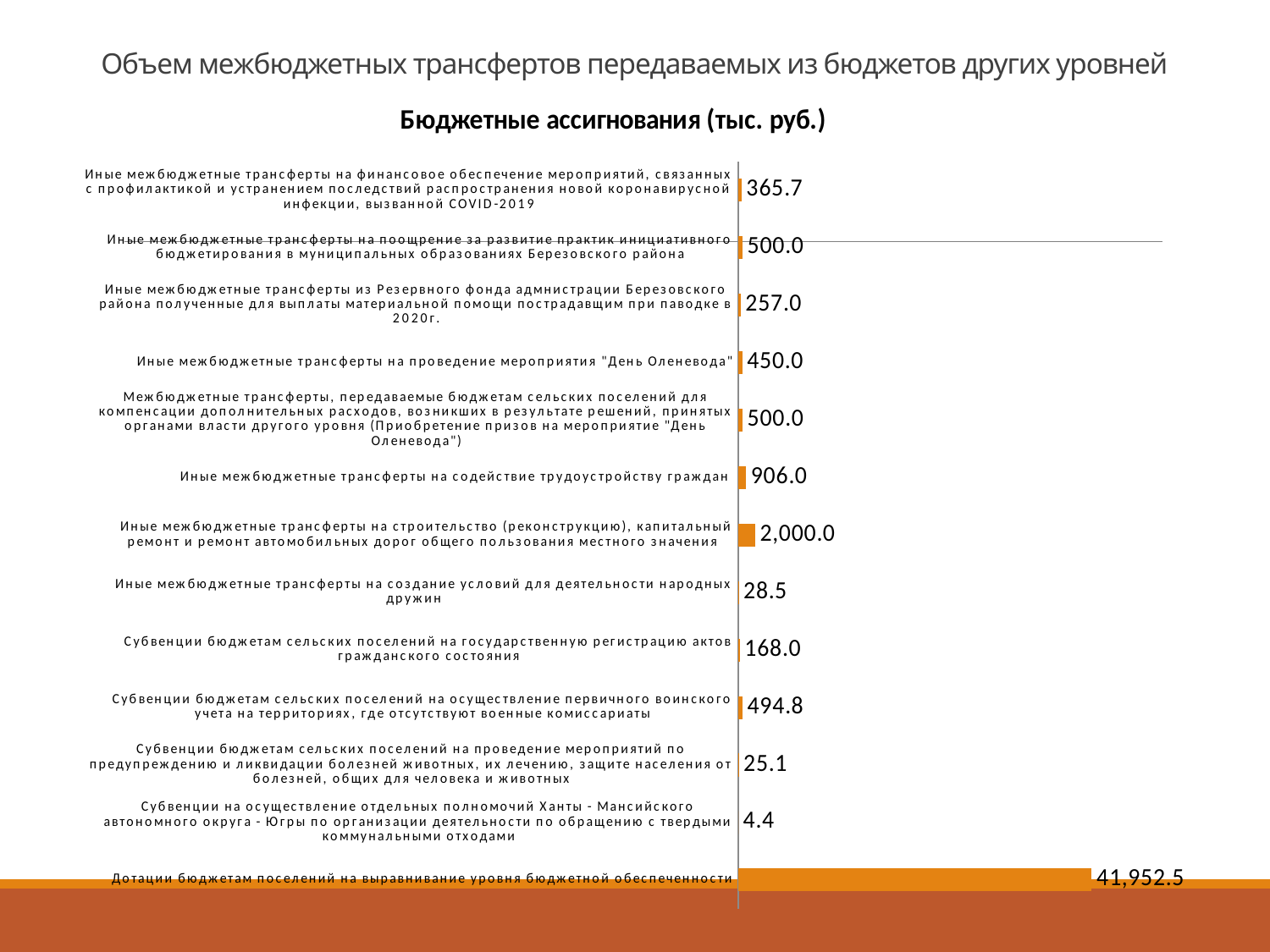
Which is larger: the value for "Субвенции бюджетам сельских поселений на осуществление первичного воинского учета" or the value for "Иные межбюджетные трансферты на проведение мероприятия "День Оленевода""? Субвенции бюджетам сельских поселений на осуществление первичного воинского учета (494.8) What is the value for "Иные межбюджетные трансферты на проведение мероприятия "День Оленевода""? 450.0 What is the difference between the value for transfers for road construction and repair (2,000.0) and the value for transfers for employment assistance (906.0)? 1,094.0 Which category has the highest value? Дотации бюджетам поселений на выравнивание уровня бюджетной обеспеченности What is the value for "Иные межбюджетные трансферты на содействие трудоустройству граждан"? 906.0 What type of chart is shown on the slide? Bar chart Which category has the lowest value? Субвенции на осуществление отдельных полномочий Ханты-Мансийского автономного округа - Югры по организации деятельности по обращению с твердыми коммунальными отходами What colour are the bars in the chart? Orange How many categories are plotted in the chart? 13 What is the value for "Иные межбюджетные трансферты на создание условий для деятельности народных дружин"? 28.5 What is the title of the chart? Бюджетные ассигнования (тыс. руб.) What is the value for "Дотации бюджетам поселений на выравнивание уровня бюджетной обеспеченности"? 41,952.5